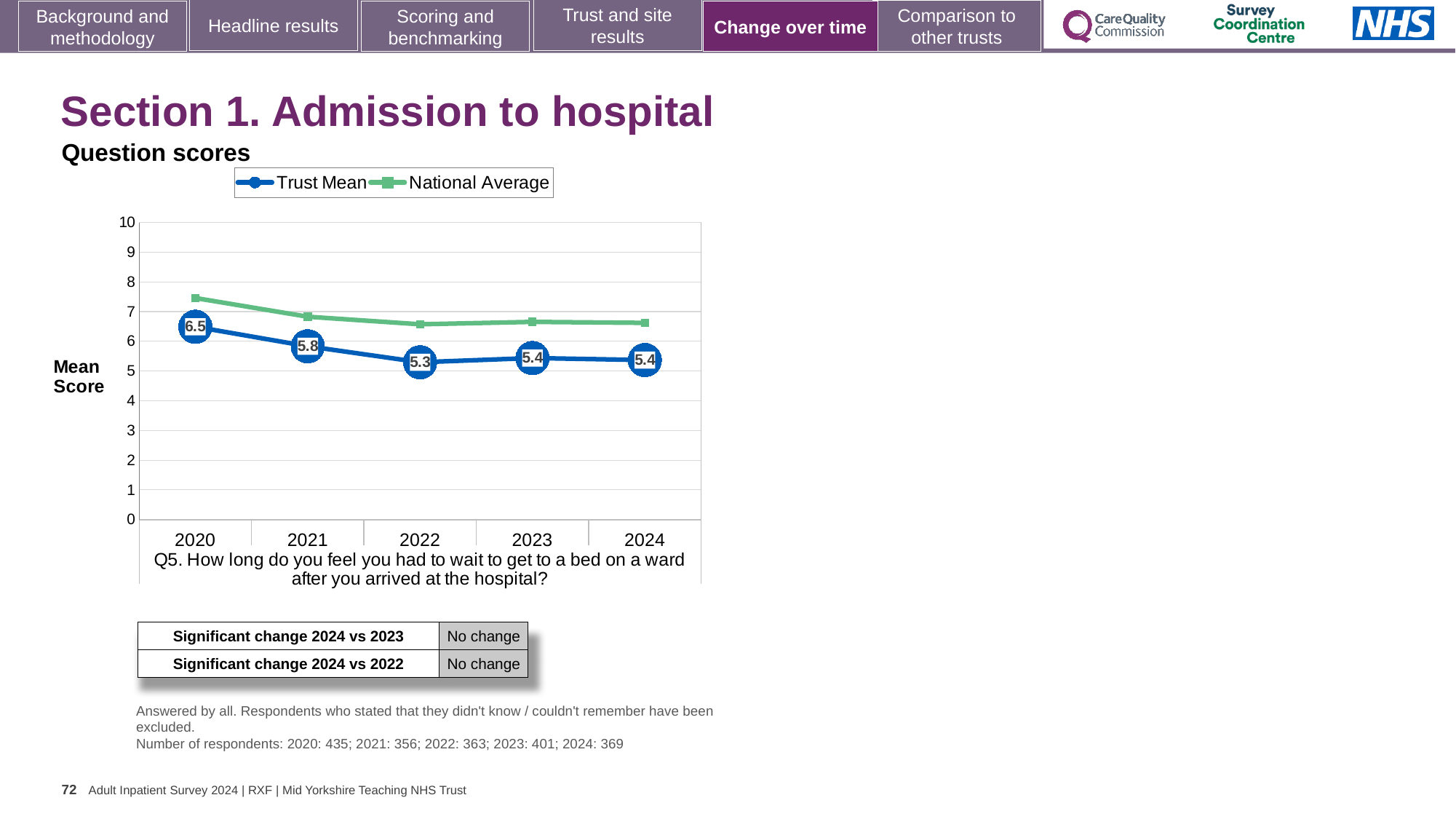
Which is higher in 2024, the Trust Mean or the National Average? National Average What is the Trust Mean score for 2024? 5.4 What is the Trust Mean score for 2022? 5.3 Is the National Average value for 2020 greater or less than 7? greater In which year is the Trust Mean score highest? 2020 What is the difference between the Trust Mean scores for 2020 and 2021? 0.7 What is the Trust Mean score for 2020? 6.5 How many years are shown on the x axis of the chart? 5 Does the Trust Mean score rise or fall from 2020 to 2024? Fall In which year is the Trust Mean score lowest? 2022 What kind of chart is shown on the slide? Line chart How many series does the chart legend list? 2